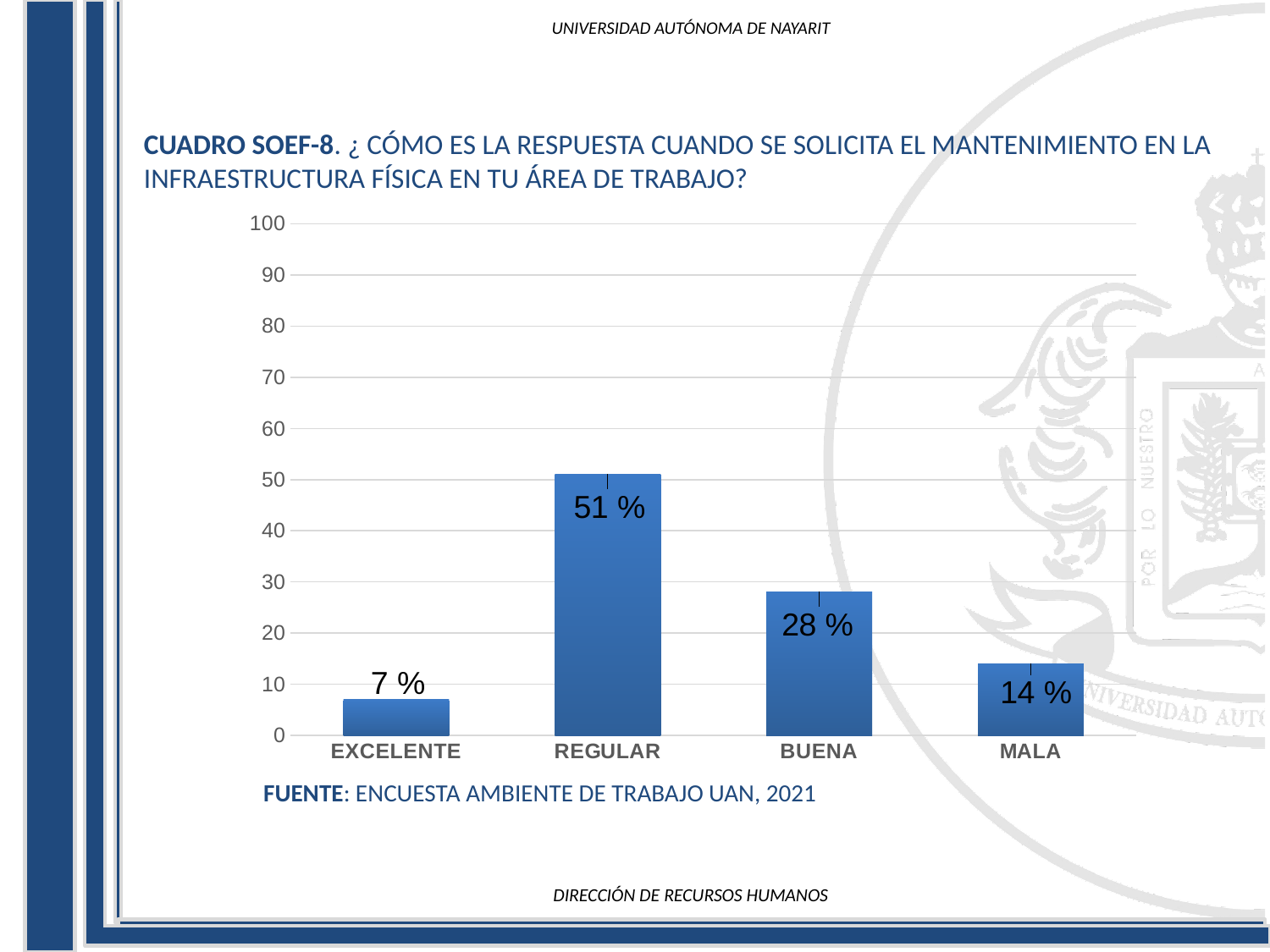
What is the value for REGULAR? 51 % What is the value for EXCELENTE? 7 % Which category has the lowest value? EXCELENTE How many categories are shown on the x axis? 4 What is the difference between the values for REGULAR and BUENA? 23 % What is the value for MALA? 14 % Is the value for REGULAR greater or less than 50? greater Which category has the highest value? REGULAR What kind of chart is shown on the slide? bar chart What is the value for BUENA? 28 % What is the source cited below the chart? ENCUESTA AMBIENTE DE TRABAJO UAN, 2021 Which is larger, the value for BUENA or the value for MALA? BUENA